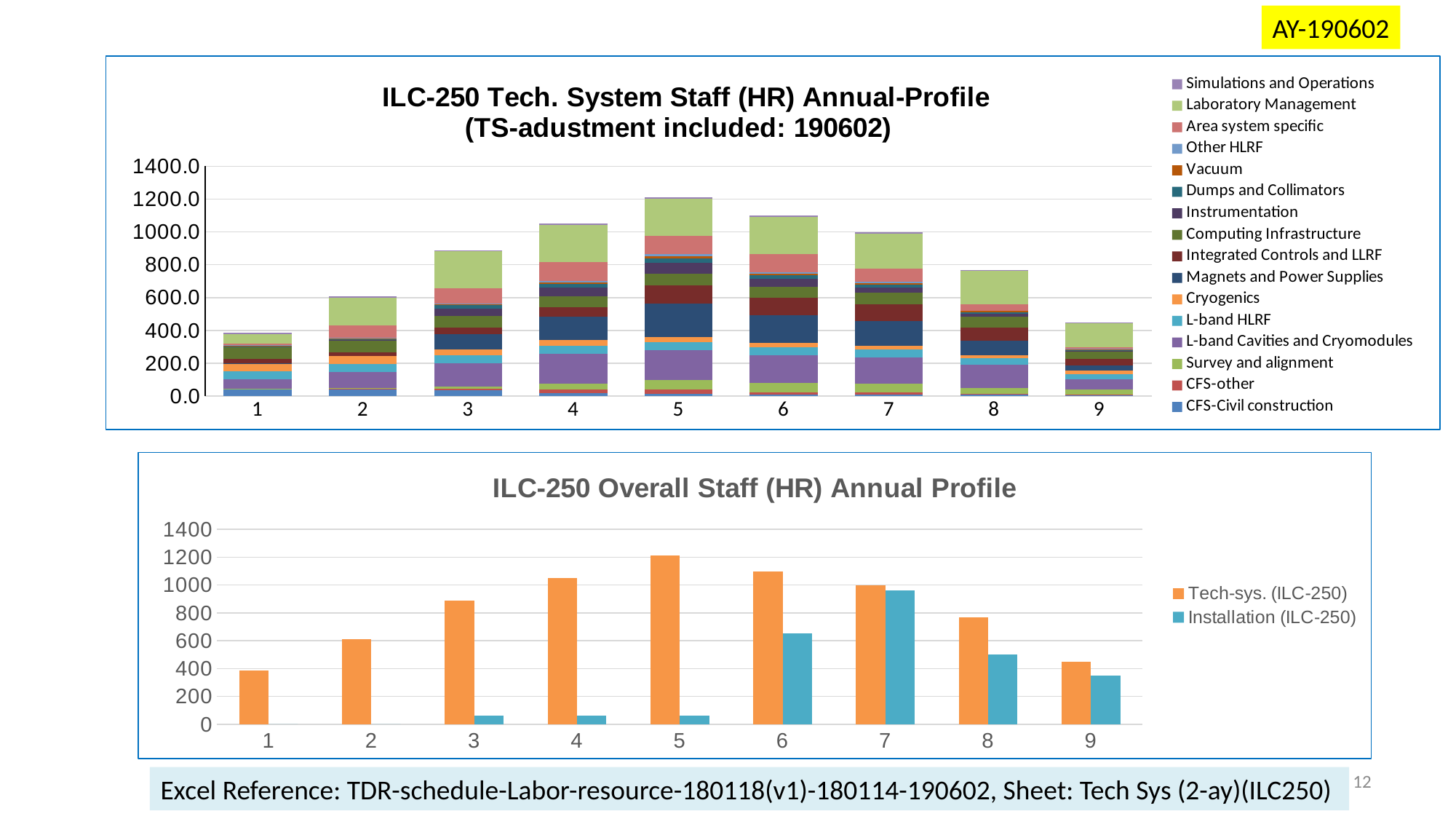
In the bottom chart, 'ILC-250 Overall Staff (HR) Annual Profile', which year has the highest Tech-sys. (ILC-250) value? 5 In the top chart, 'ILC-250 Tech. System Staff (HR) Annual-Profile', is the total for year 5 greater or less than 1000? greater In the bottom chart, 'ILC-250 Overall Staff (HR) Annual Profile', is the Installation (ILC-250) value for year 6 greater or less than 600? greater What kind of chart is the top chart, 'ILC-250 Tech. System Staff (HR) Annual-Profile'? stacked bar chart How many series does the legend of the top chart, 'ILC-250 Tech. System Staff (HR) Annual-Profile', list? 16 In the top chart, 'ILC-250 Tech. System Staff (HR) Annual-Profile', which year has the tallest stacked bar? 5 In the top chart, 'ILC-250 Tech. System Staff (HR) Annual-Profile', which year has the shortest stacked bar? 1 In the bottom chart, 'ILC-250 Overall Staff (HR) Annual Profile', which year has the highest Installation (ILC-250) value? 7 In the bottom chart, 'ILC-250 Overall Staff (HR) Annual Profile', does the Tech-sys. (ILC-250) value rise or fall from year 5 to year 9? fall How many years are shown on the x axis of the bottom chart, 'ILC-250 Overall Staff (HR) Annual Profile'? 9 How many series does the legend of the bottom chart, 'ILC-250 Overall Staff (HR) Annual Profile', list? 2 In the top chart, 'ILC-250 Tech. System Staff (HR) Annual-Profile', which is larger, the total for year 3 or the total for year 8? year 3